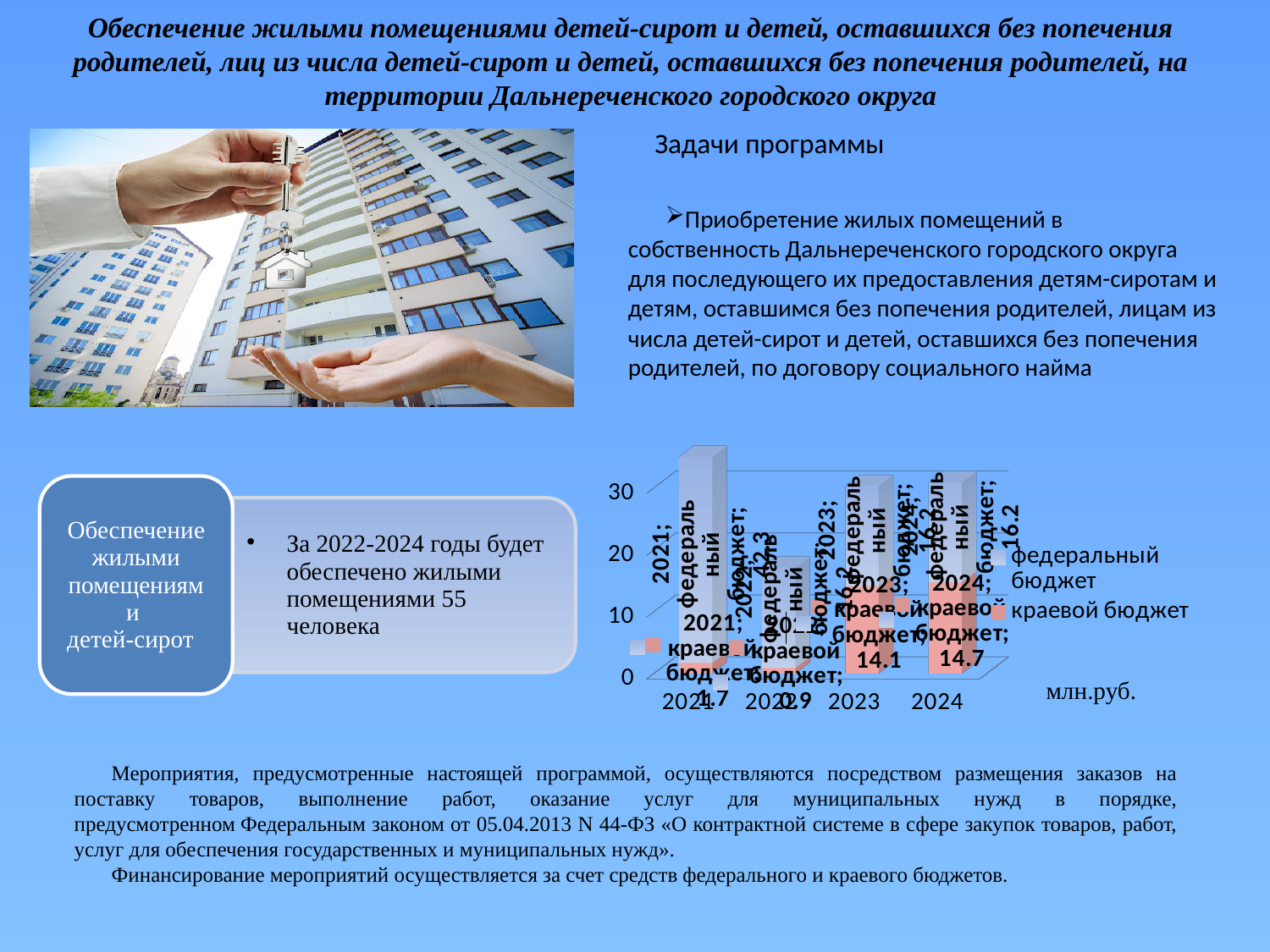
What is the value of краевой бюджет for 2021? 1.7 What kind of chart is shown on the slide? bar chart In which year is краевой бюджет highest? 2024 What is the value of федеральный бюджет for 2024? 16.2 Is the value of федеральный бюджет for 2021 greater or less than 20? greater What is the value of краевой бюджет for 2023? 14.1 What is the difference between краевой бюджет in 2024 and in 2023? 0.6 In which year is краевой бюджет lowest? 2022 Which is larger in 2023: федеральный бюджет or краевой бюджет? федеральный бюджет What is the value of краевой бюджет for 2022? 0.9 How many series does the chart legend list? 2 How many years are shown on the x axis of the chart? 4